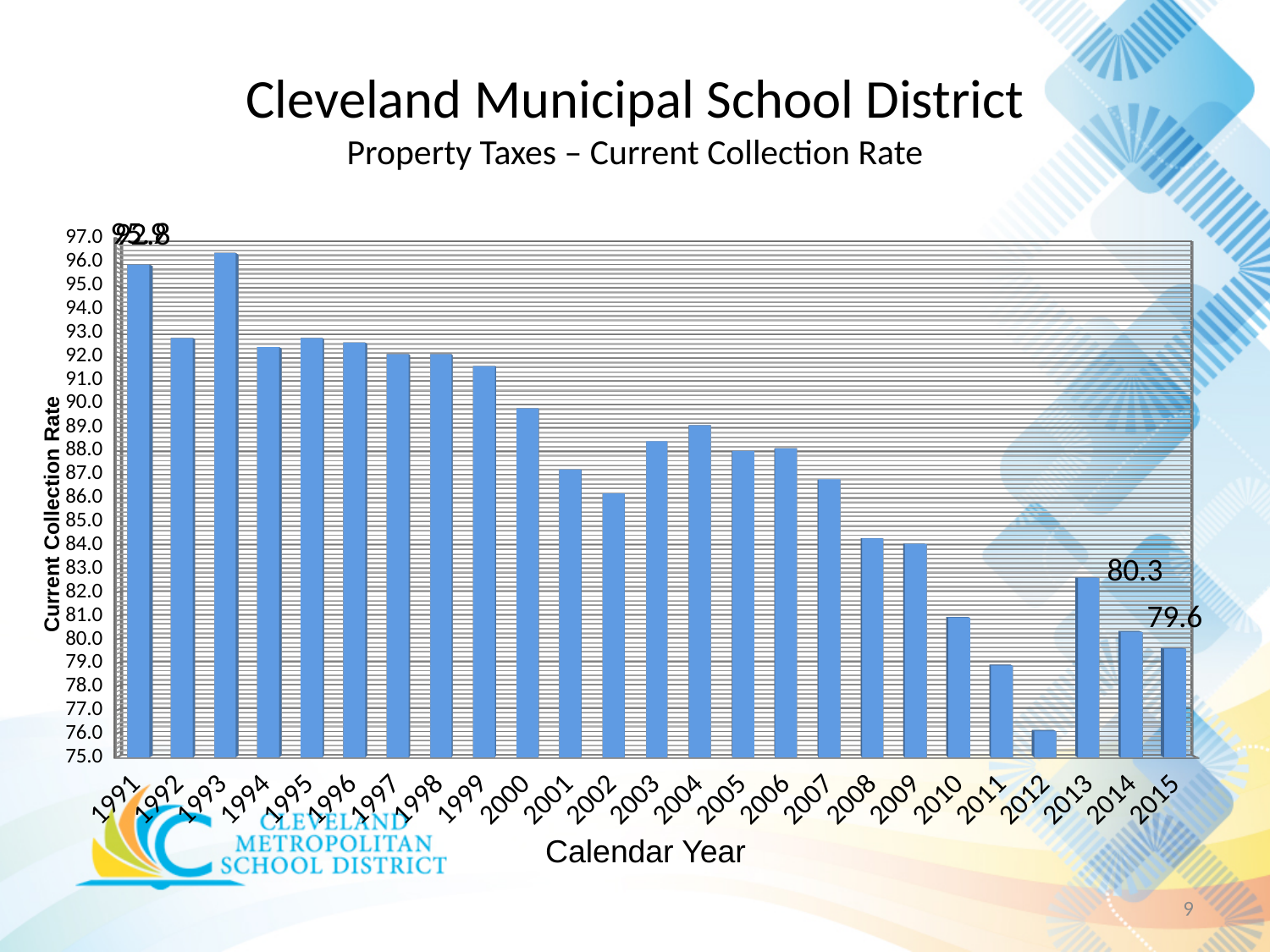
What is the current collection rate for 2014? 80.3 What kind of chart is shown on the slide? bar chart Which calendar year has the highest current collection rate? 1993 What is the label on the y axis? Current Collection Rate Overall, do the collection rates rise or fall from 1991 to 2015? fall Which year has the larger collection rate, 2004 or 2005? 2004 What is the current collection rate for 2015? 79.6 Is the value for 2011 greater or less than 80.0? less What is the difference between the collection rates for 2014 and 2015? 0.7 Is the value for 2000 greater or less than 89.0? greater How many calendar years are plotted on the x axis? 25 Which calendar year has the lowest current collection rate? 2012